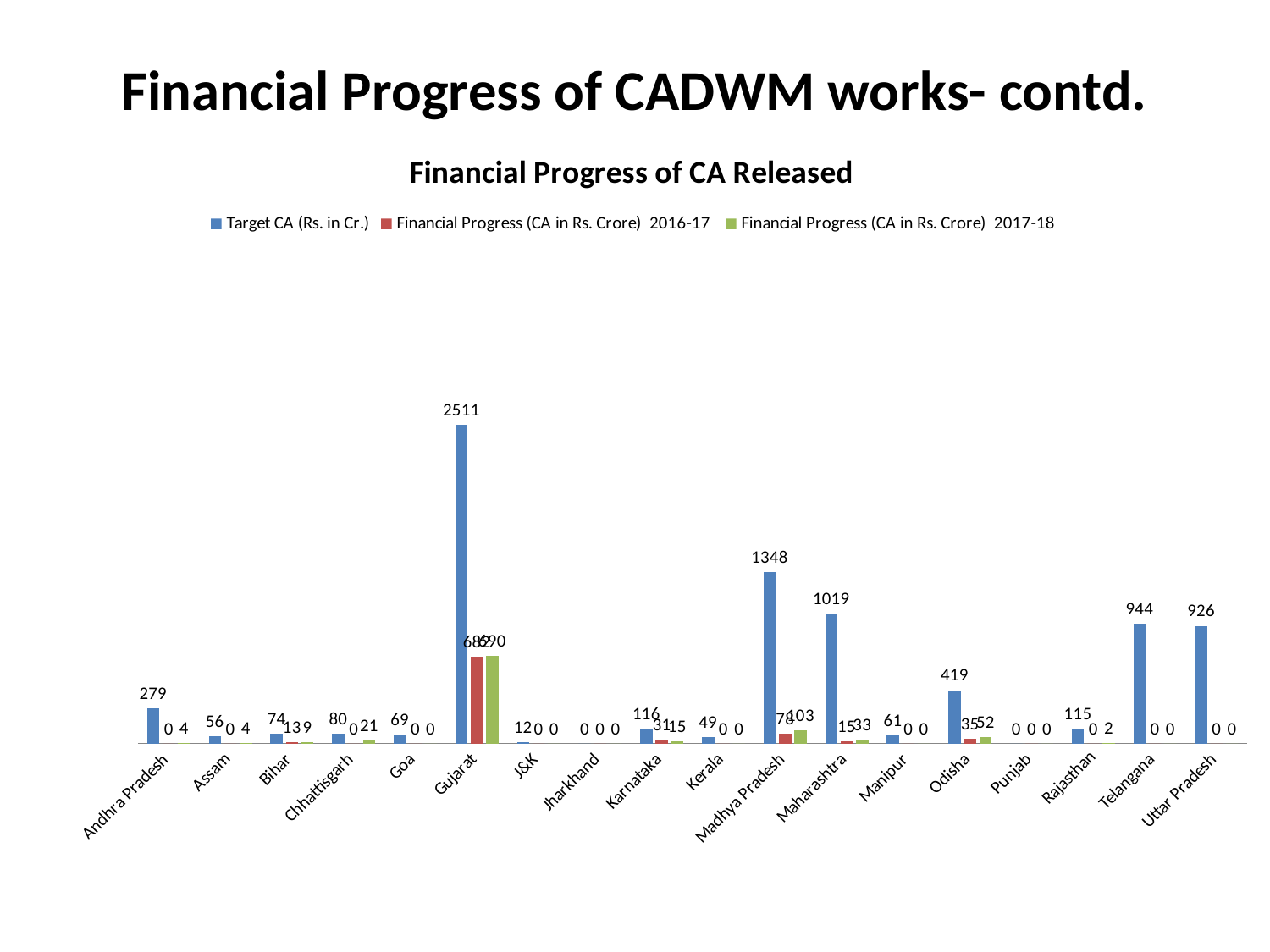
What is the difference between the Target CA values for Madhya Pradesh and Maharashtra? 329 What is the Target CA (Rs. in Cr.) value for Andhra Pradesh? 279 How many series does the legend list? 3 Which state has the highest Target CA (Rs. in Cr.)? Gujarat How many states are shown on the x axis of the chart? 18 What is the Target CA (Rs. in Cr.) value for Gujarat? 2511 What is the Financial Progress (CA in Rs. Crore) 2017-18 value for Chhattisgarh? 21 What kind of chart is shown on the slide? Bar chart What is the Target CA (Rs. in Cr.) value for Madhya Pradesh? 1348 What is the Target CA (Rs. in Cr.) value for Odisha? 419 What is the difference between the Target CA values for Telangana and Uttar Pradesh? 18 Which has a larger Target CA (Rs. in Cr.), Telangana or Uttar Pradesh? Telangana